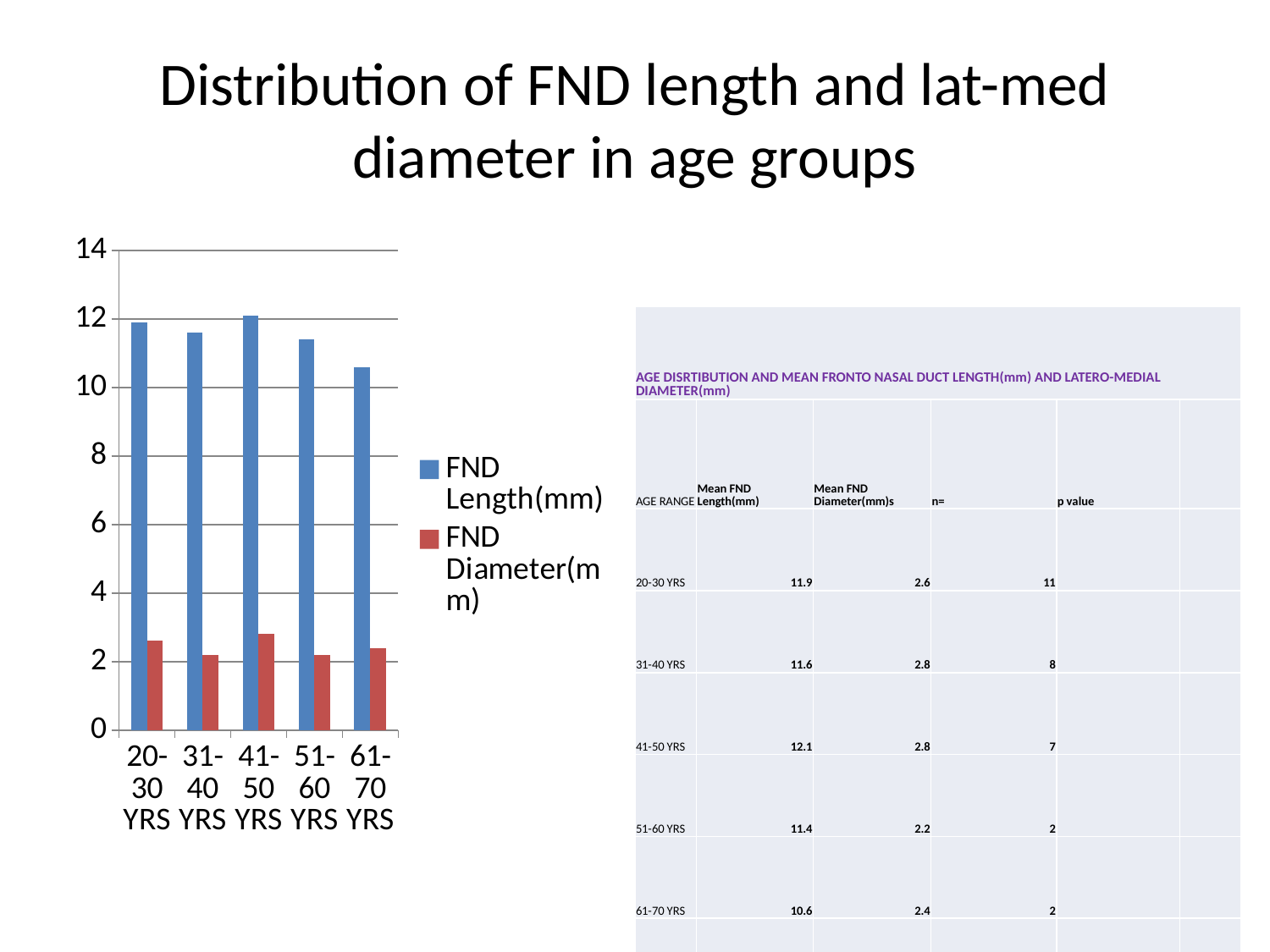
For the 20-30 YRS group, which is larger: FND Length(mm) or FND Diameter(mm)? FND Length(mm) What are the two series named in the chart legend? FND Length(mm) and FND Diameter(mm) According to the table on the slide, what is the mean FND length (mm) for the 20-30 YRS group? 11.9 Is the FND Diameter(mm) value for 20-30 YRS greater or less than 4? less Is the FND Length(mm) value for 61-70 YRS greater or less than 12? less How many series does the chart legend list? 2 Is the FND Length(mm) value for 41-50 YRS greater or less than 12? greater How many age groups are shown on the x axis of the chart? 5 Does the FND Length(mm) value rise or fall from 51-60 YRS to 61-70 YRS? fall What kind of chart is shown on the slide? bar chart Which age group has the highest FND Length(mm) bar? 41-50 YRS Which age group has the lowest FND Length(mm) bar? 61-70 YRS